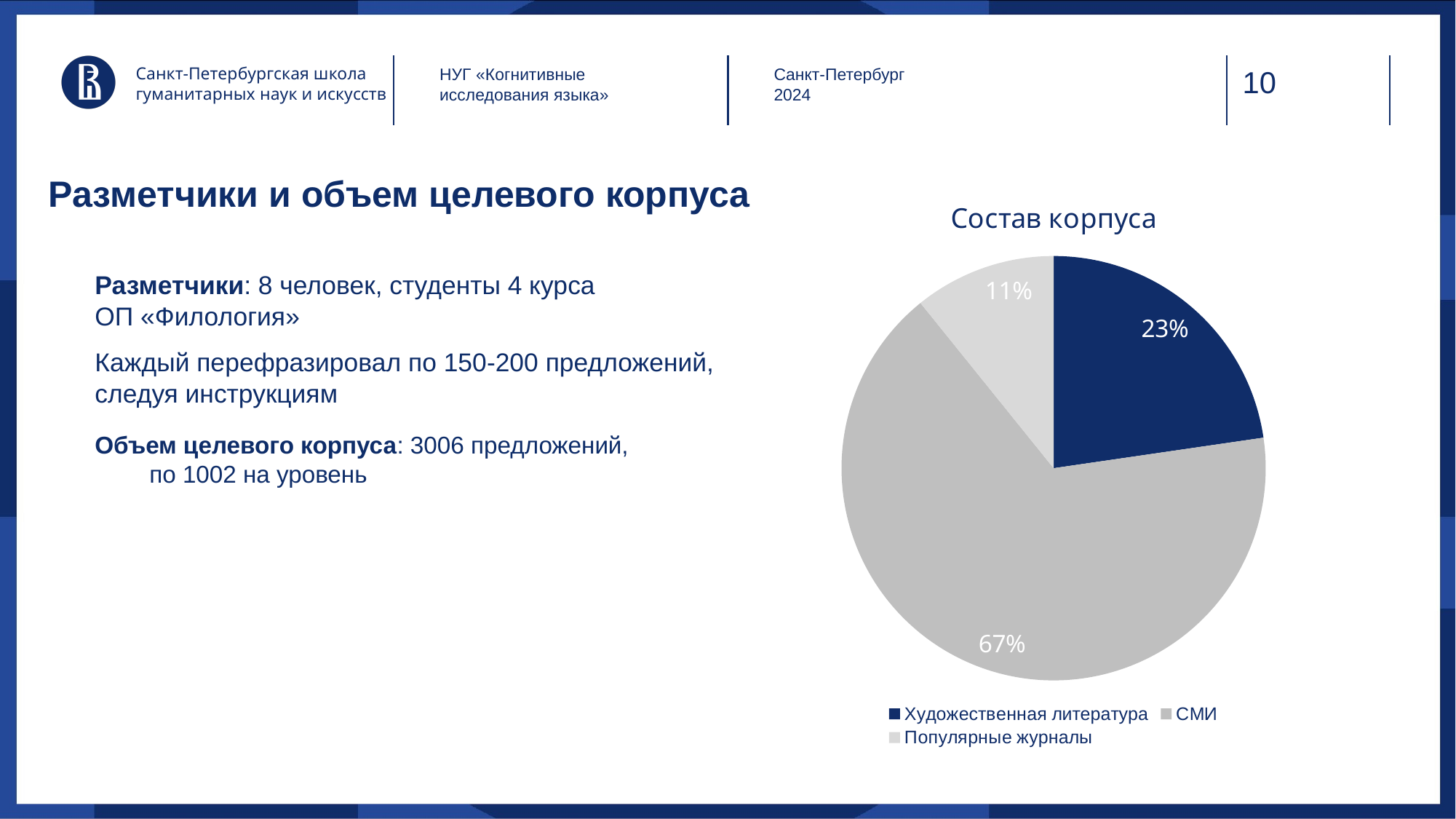
What share of the pie does Художественная литература take? 23% How many categories does the pie chart have? 3 What type of chart is shown on the slide? pie chart Which category has the largest slice of the pie? СМИ What is the difference between the shares of Художественная литература and Популярные журналы? 12% What share of the pie does Популярные журналы take? 11% Which category has the smallest slice of the pie? Популярные журналы What is the difference between the shares of СМИ and Художественная литература? 44% What is the title of the chart? Состав корпуса What share of the pie does СМИ take? 67% Which category is shown in dark blue in the legend? Художественная литература Which is larger, the share of Художественная литература or the share of Популярные журналы? Художественная литература